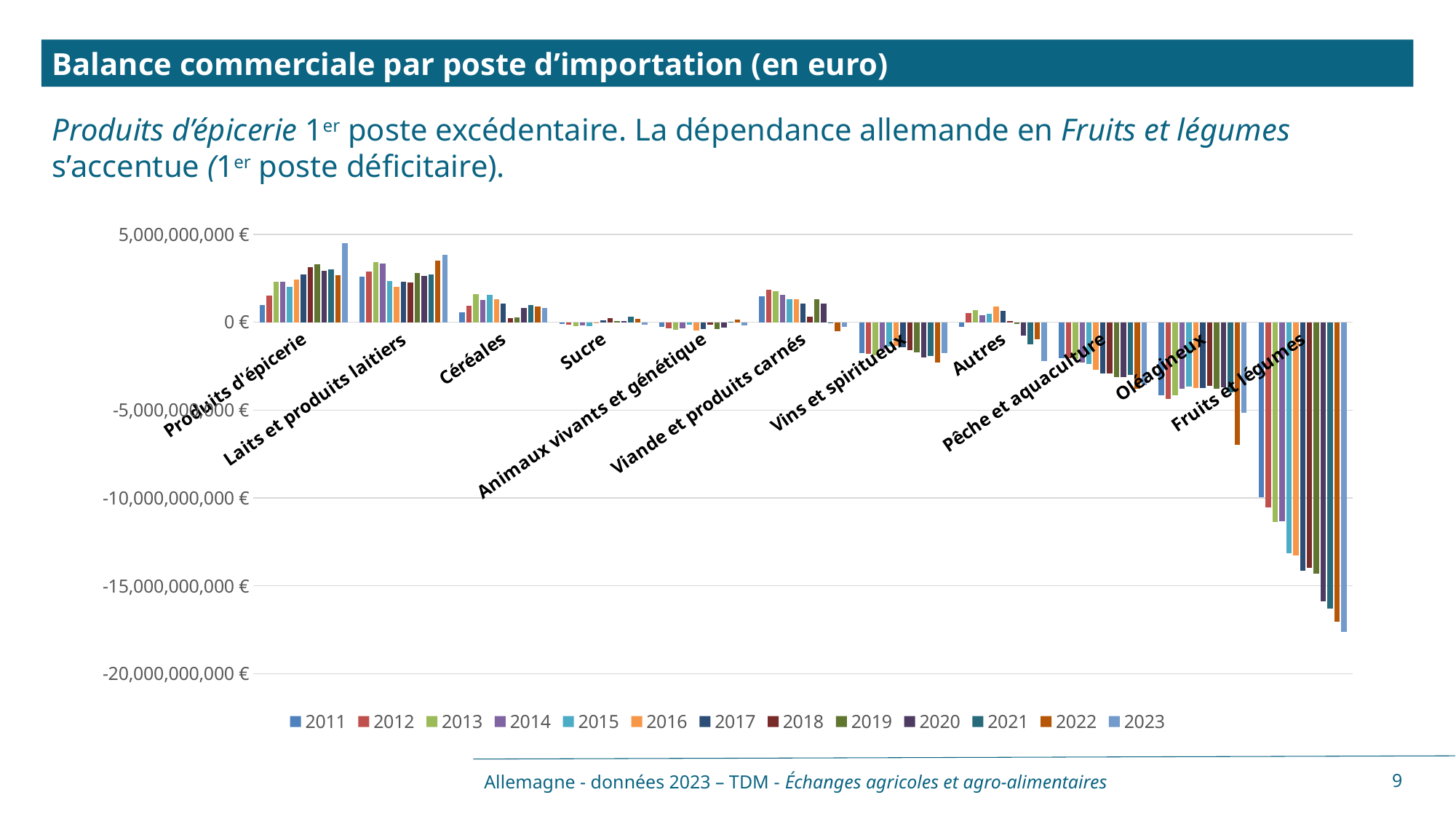
What kind of chart is shown on the slide? bar chart Is the value for Pêche et aquaculture in 2022 greater or less than -5,000,000,000 €? greater For Fruits et légumes, which is larger: the value for 2011 or the value for 2023? 2011 Is the value for Produits d'épicerie in 2023 greater or less than 5,000,000,000 €? less How many series does the legend list? 13 What is the title of the chart? Balance commerciale par poste d'importation (en euro) Which category has the lowest (most negative) trade balance? Fruits et légumes Do the values for Fruits et légumes rise or fall from 2011 to 2023? fall Which category has the highest trade balance in 2023? Produits d'épicerie Is the value for Fruits et légumes in 2023 greater or less than -15,000,000,000 €? less How many import categories are shown on the x axis? 11